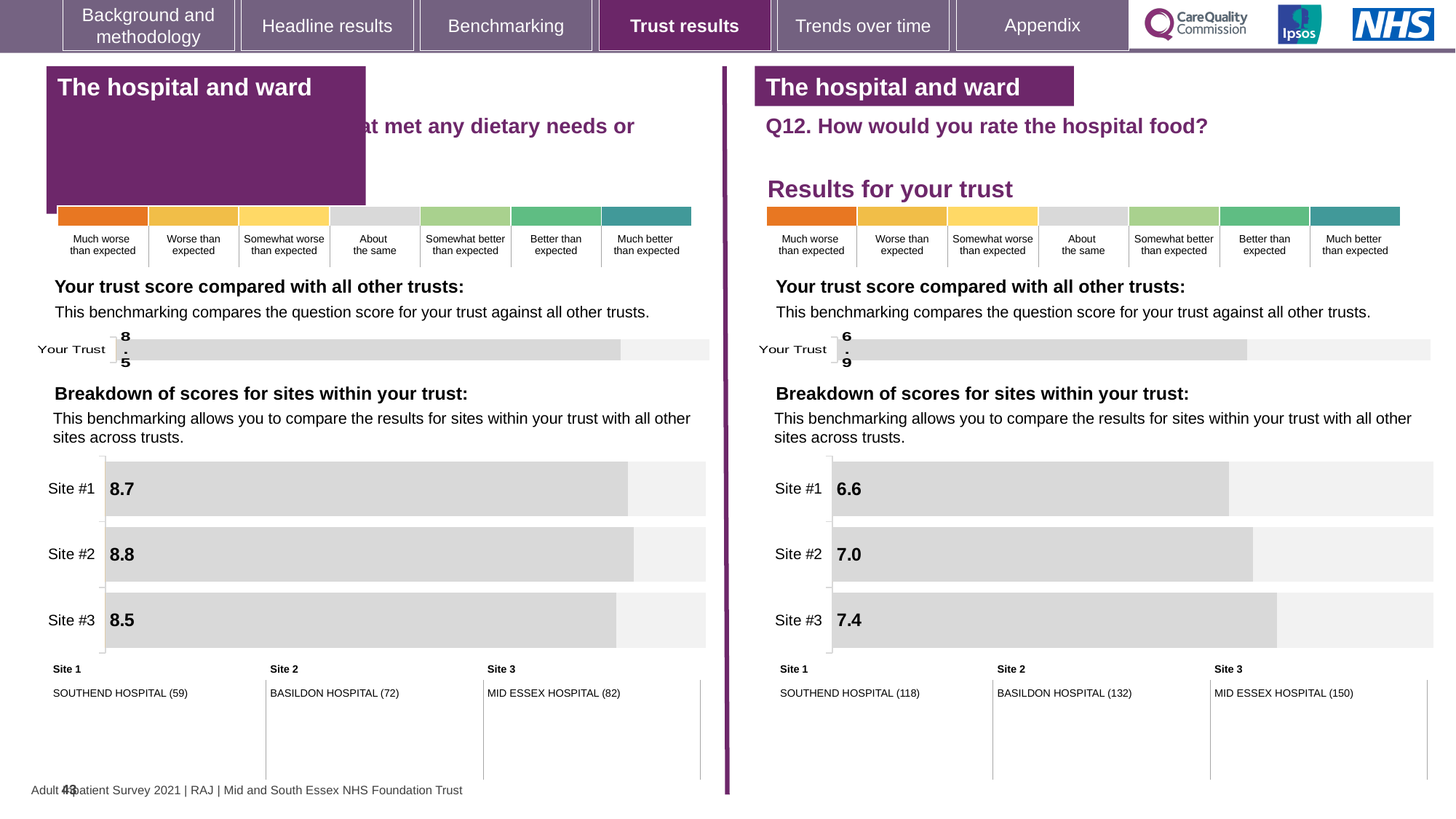
On the left-hand chart, which is larger, the score for Site #1 or Site #3? Site #1 What type of chart is used for the breakdown of scores for sites on the right-hand side? Bar chart On the left-hand chart, which site has the lowest score? Site #3 On the left-hand chart, what is the score for Site #2? 8.8 On the right-hand chart (Q12, hospital food), what is the score for Site #3? 7.4 On the right-hand chart (Q12, hospital food), what is the score for Site #1? 6.6 On the right-hand chart (Q12, hospital food), what is the difference between the Site #3 and Site #1 scores? 0.8 On the right-hand chart (Q12, hospital food), what is the 'Your Trust' score? 6.9 On the left-hand chart, what is the 'Your Trust' score? 8.5 On the right-hand chart (Q12, hospital food), which site has the highest score? Site #3 On the right-hand chart (Q12, hospital food), which site has the lowest score? Site #1 How many sites are shown in the site breakdown on the right-hand chart (Q12, hospital food)? 3